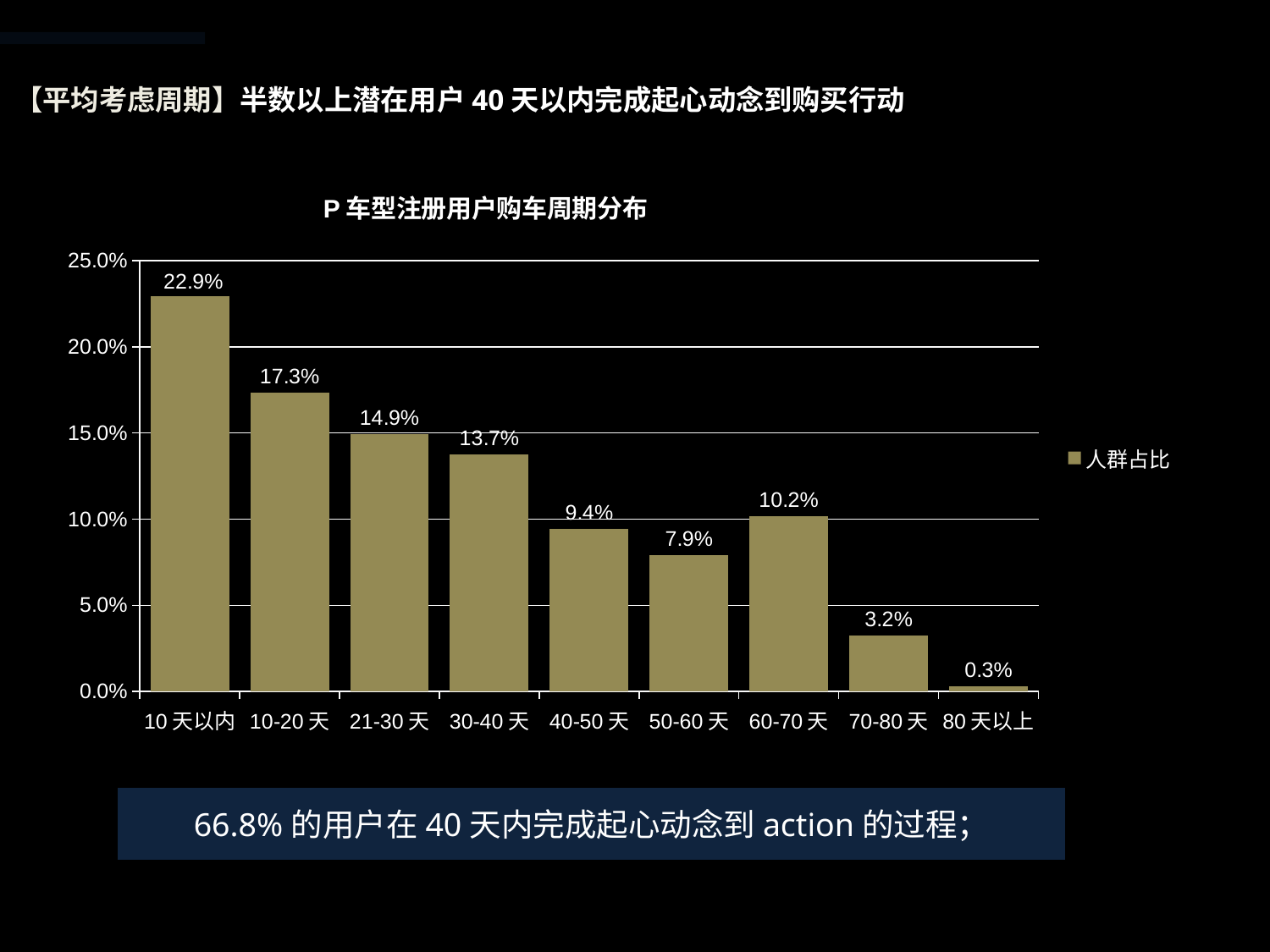
Is the value for 21-30 天 greater or less than 10.0%? greater What is the value for 80 天以上? 0.3% What is the value for 60-70 天? 10.2% What is the title of the chart? P 车型注册用户购车周期分布 What kind of chart is shown? bar chart Which category has the highest value? 10 天以内 Which is larger, the value for 50-60 天 or the value for 60-70 天? 60-70 天 Which category has the lowest value? 80 天以上 What is the value for 10 天以内? 22.9% How many series does the legend list? 1 What is the difference between the values for 10 天以内 and 10-20 天? 5.6% How many categories are shown on the x axis? 9